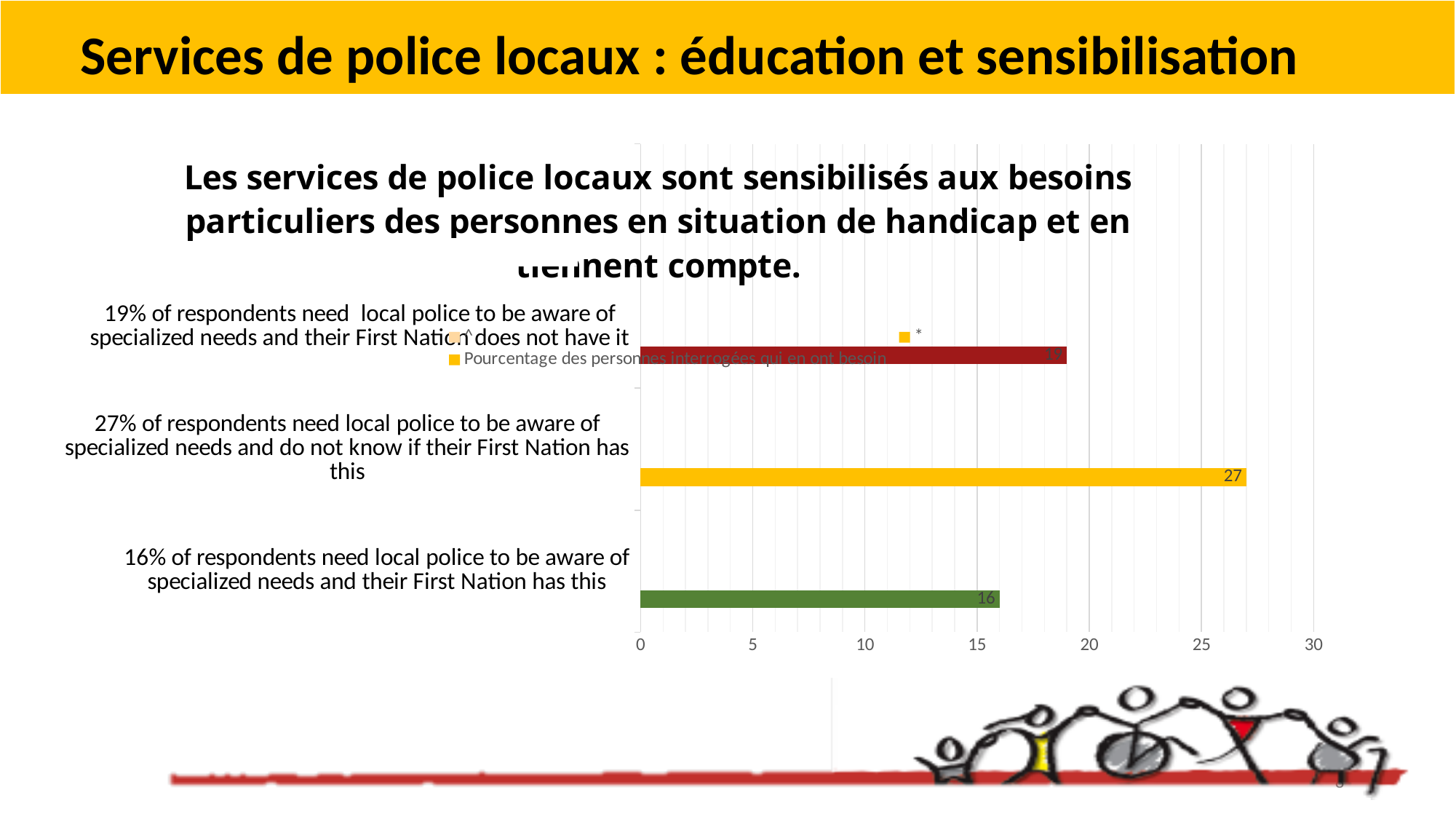
What type of chart is shown on the slide? bar chart How many categories (bars) does the chart show? 3 What is the difference between the value for respondents who do not know if their First Nation has this and the value for respondents whose First Nation has this? 11 Which is larger: the value for respondents whose First Nation does not have it or the value for respondents whose First Nation has this? their First Nation does not have it (19) Which category has the highest value? 27% of respondents need local police to be aware of specialized needs and do not know if their First Nation has this What is the value of the bar for respondents whose First Nation does not have it? 19 What is the maximum value shown on the horizontal axis? 30 What is the value of the bar for respondents who do not know if their First Nation has this? 27 What colour is the bar for respondents whose First Nation has this? green Which category has the lowest value? 16% of respondents need local police to be aware of specialized needs and their First Nation has this What is the value of the bar for respondents whose First Nation has this? 16 Is the value for respondents who do not know if their First Nation has this greater or less than 25? greater